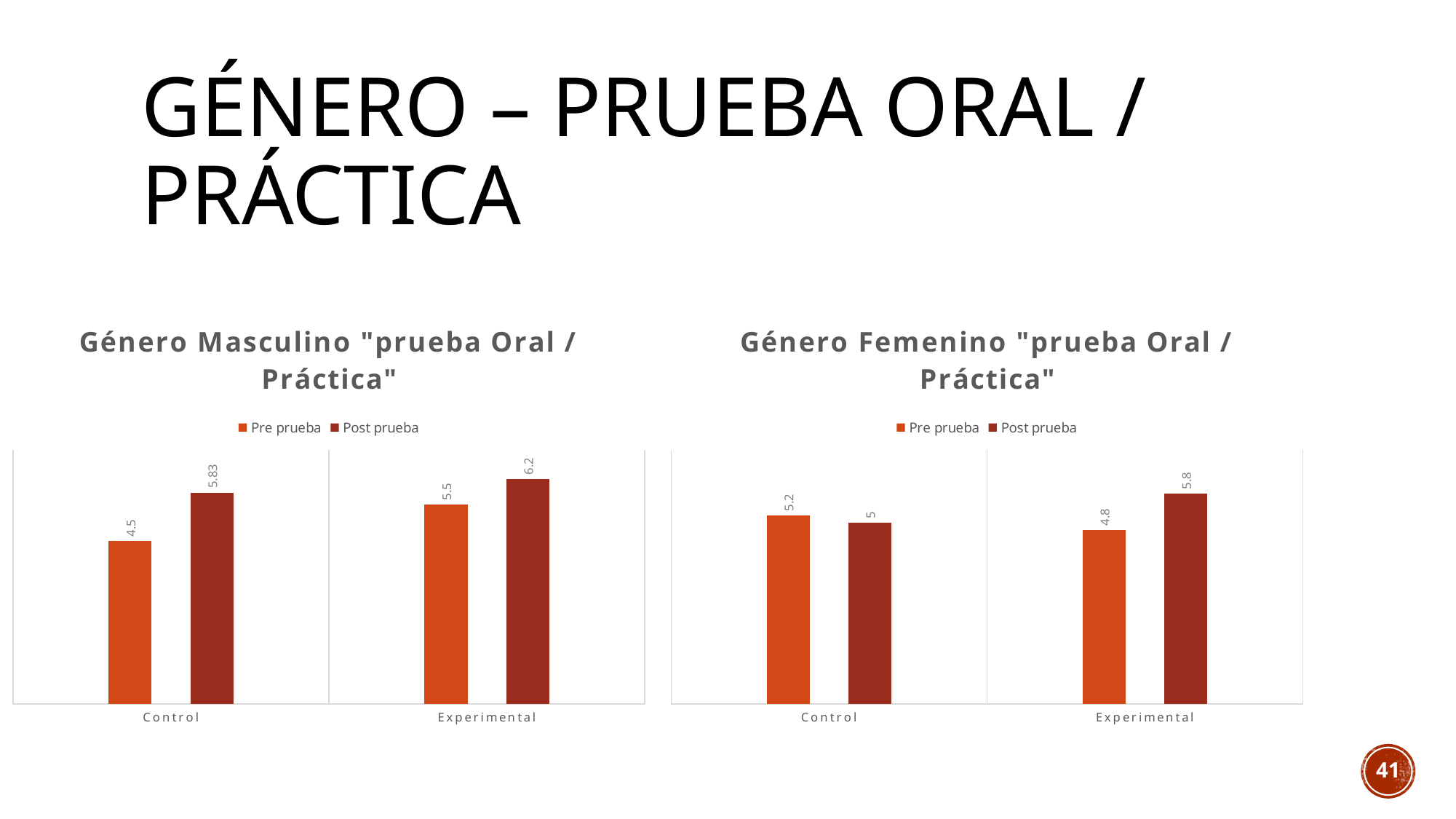
In the "Género Masculino" chart, what is the Pre prueba value for Control? 4.5 In the "Género Femenino" chart, which bar has the lowest value? Pre prueba, Experimental In the "Género Femenino" chart, which is larger for Control: Pre prueba or Post prueba? Pre prueba In the "Género Masculino" chart, what is the difference between the Post prueba and Pre prueba values for Control? 1.33 In the "Género Femenino" chart, what is the Pre prueba value for Experimental? 4.8 How many series does the legend of the "Género Masculino" chart list? 2 What kind of chart is the "Género Masculino" chart? Bar chart How many categories are shown on the x axis of the "Género Femenino" chart? 2 In the "Género Masculino" chart, what is the Post prueba value for Experimental? 6.2 In the "Género Femenino" chart, what is the difference between the Post prueba and Pre prueba values for Experimental? 1 In the "Género Masculino" chart, which bar has the highest value? Post prueba, Experimental In the "Género Femenino" chart, what is the Post prueba value for Control? 5